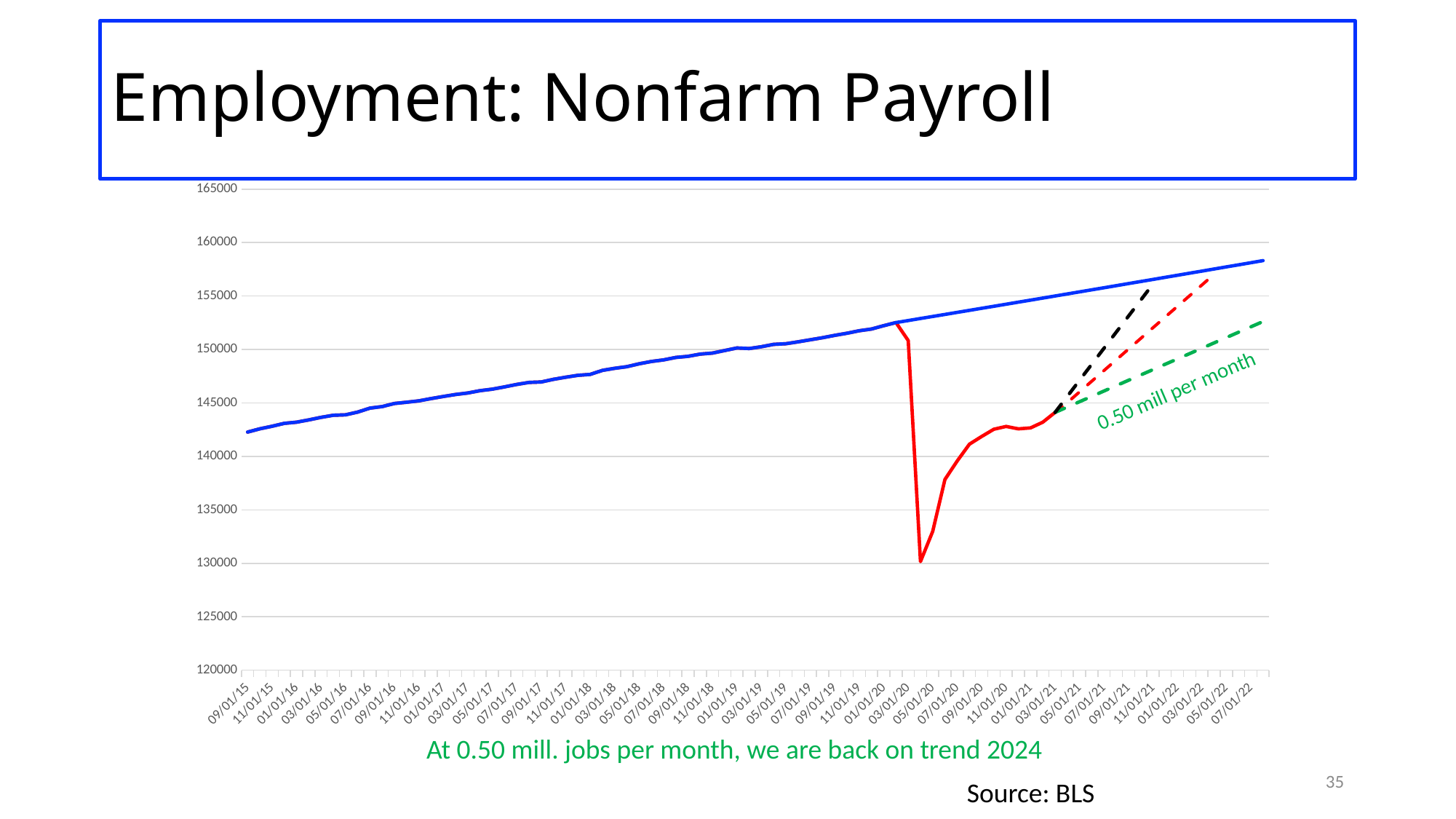
Is the value of the blue trend line at 07/01/22 greater or less than 155000? greater Is the lowest point of the red line (around 04/01/20) greater or less than 135000? less Is the value of the red line at 03/01/21 greater or less than 145000? less What is the highest value shown on the vertical axis? 165000 Does the blue trend line rise or fall from 09/01/15 to 07/01/22? rises Which is larger: the blue line value at 01/01/20 or the red line value at 03/01/21? the blue line value at 01/01/20 What kind of chart is shown on the slide? line chart What is the source cited for the chart? BLS What is the title of the slide containing the chart? Employment: Nonfarm Payroll Does the red line rise or fall between 01/01/20 and 04/01/20? falls